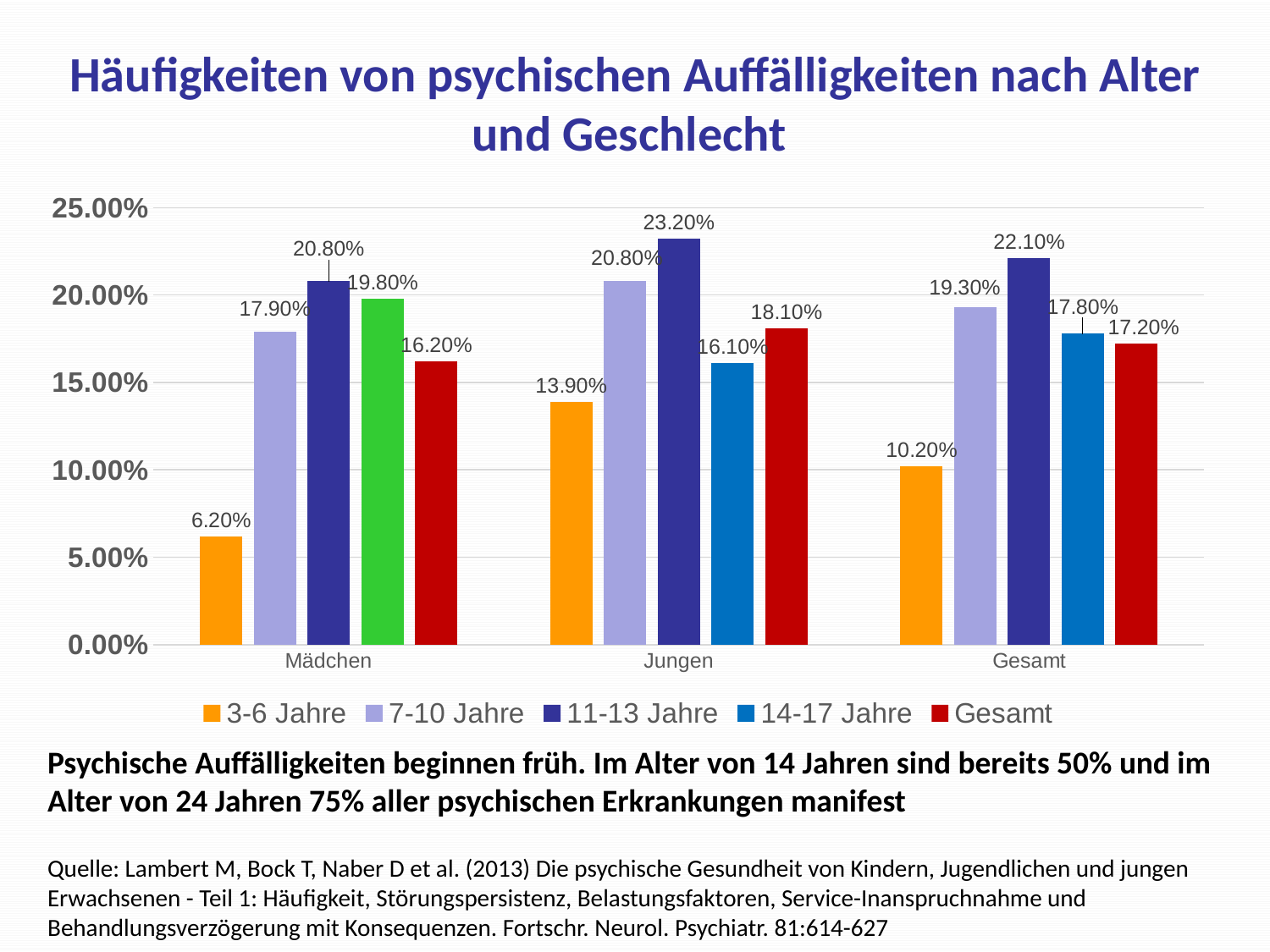
What is the value for 14-17 Jahre in the Gesamt category? 17.80% What kind of chart is shown on the slide? bar chart Is the value for 7-10 Jahre in the Mädchen category greater or less than 15.00%? greater Which series has the lowest value in the Jungen category? 3-6 Jahre What is the difference between the 11-13 Jahre value for Jungen and the 11-13 Jahre value for Mädchen? 2.40% What is the value for 11-13 Jahre in the Jungen category? 23.20% What is the value for 3-6 Jahre in the Mädchen category? 6.20% Which is larger: the 3-6 Jahre value for Jungen or the 3-6 Jahre value for Gesamt? Jungen What is the title of the chart? Häufigkeiten von psychischen Auffälligkeiten nach Alter und Geschlecht How many categories are shown on the x axis? 3 How many series does the legend list? 5 Which series has the highest value in the Gesamt category? 11-13 Jahre